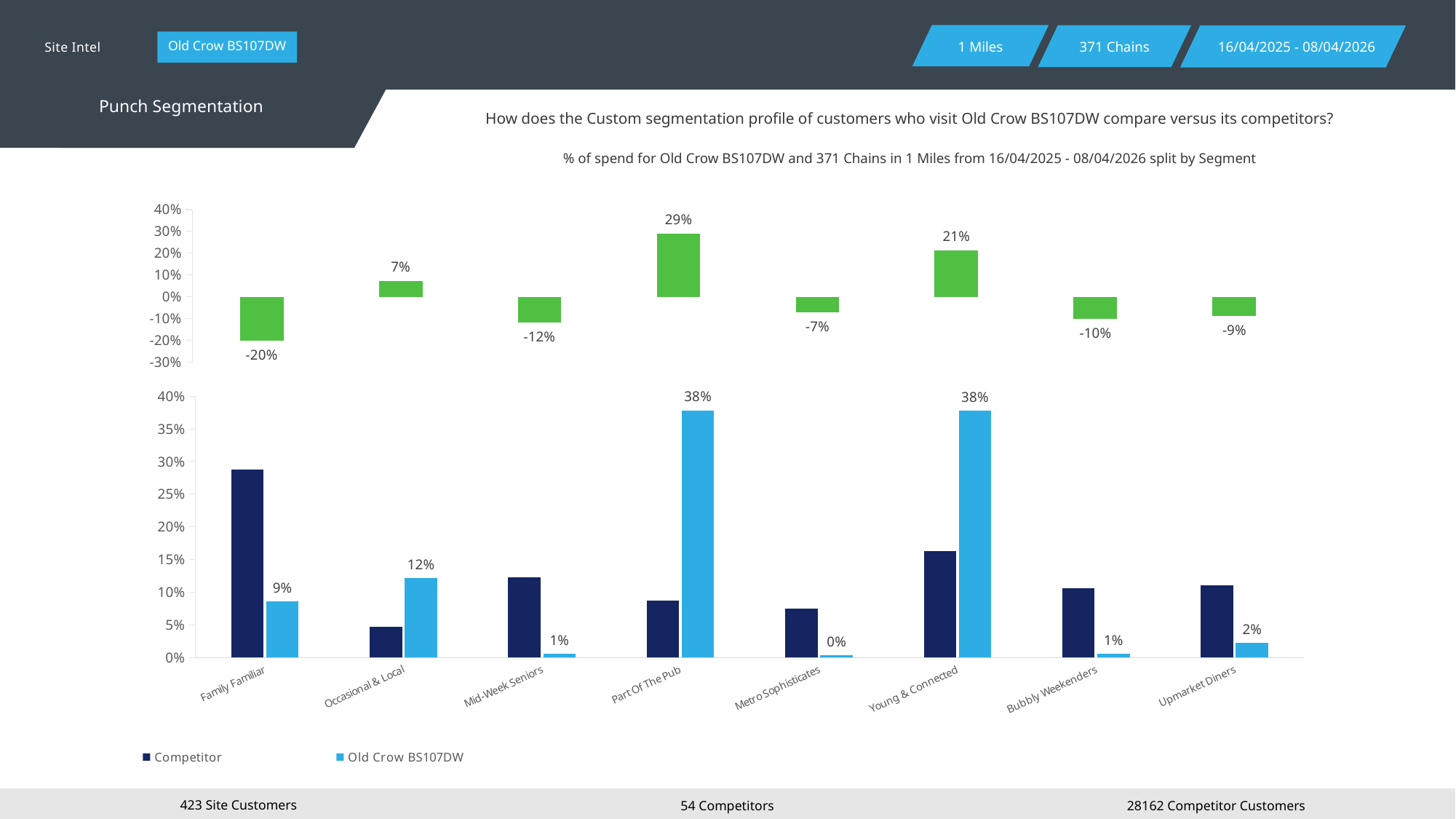
How many segments are shown on the x axis of the bottom chart? 8 In the bottom chart, for the Family Familiar segment, which is larger: the Competitor bar or the Old Crow BS107DW bar? Competitor In the top chart, which segment has the lowest value? Family Familiar In the bottom chart, is the Competitor value for Family Familiar greater or less than 25%? greater What type of chart is the bottom chart? Bar chart In the top chart, what is the difference between the Part Of The Pub value and the Young & Connected value? 8 percentage points In the bottom chart, which segment has the lowest Old Crow BS107DW value? Metro Sophisticates In the bottom chart, what is the value for Old Crow BS107DW in the Occasional & Local segment? 12% In the bottom chart, what is the value for Old Crow BS107DW in the Part Of The Pub segment? 38% In the top chart, which segment has the highest value? Part Of The Pub In the top chart, what is the value shown for the Family Familiar segment? -20% How many series does the legend of the bottom chart list? 2